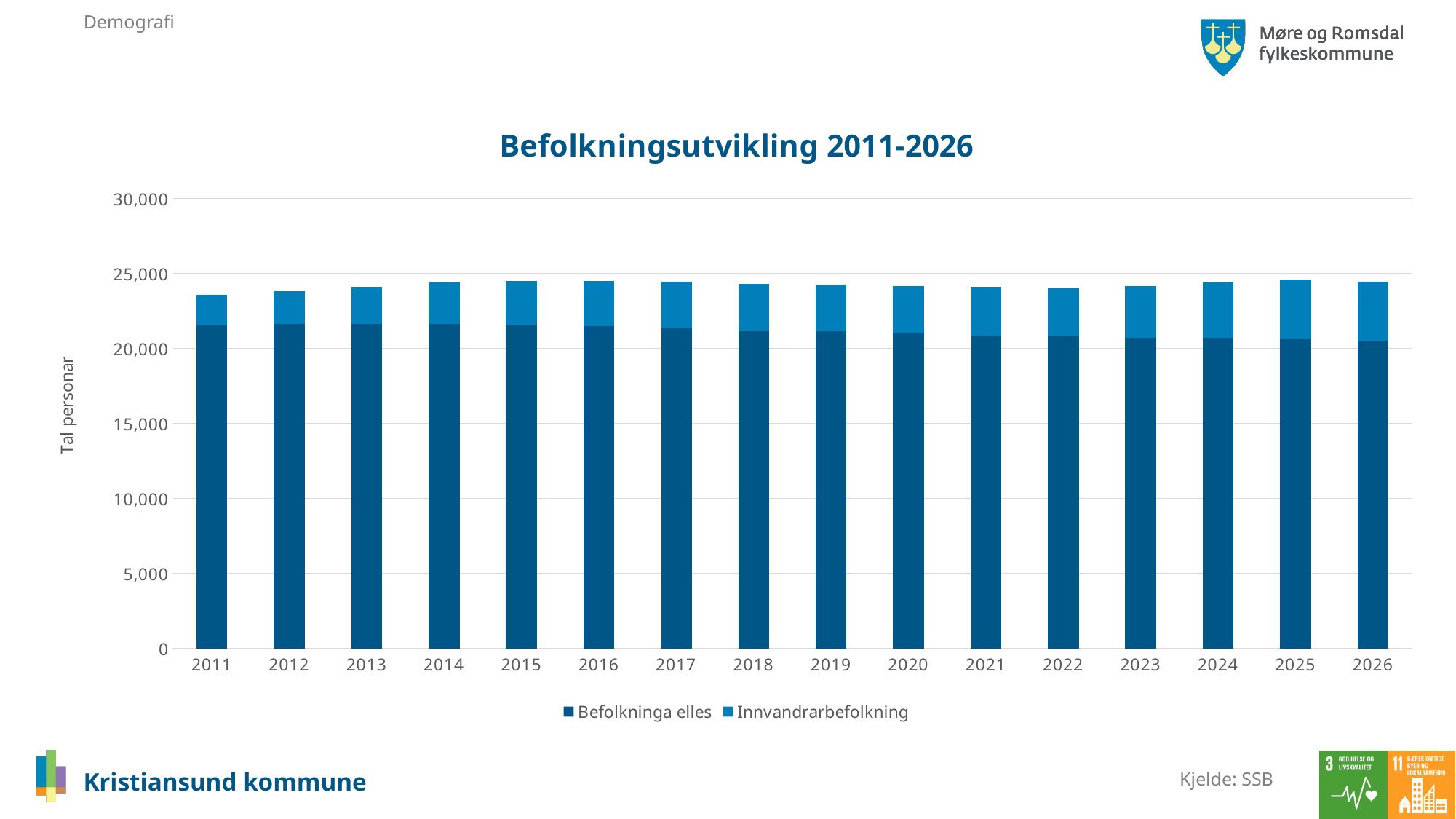
What is the title of the chart? Befolkningsutvikling 2011-2026 Which is larger, the Innvandrarbefolkning value in 2011 or in 2026? 2026 How many series does the legend list? 2 What is the label on the vertical axis? Tal personar Is the value for Befolkninga elles in 2026 greater or less than 20,000? greater Is the total bar for 2025 greater or less than 20,000? greater Is the value for Befolkninga elles in 2011 greater or less than 25,000? less What kind of chart is shown on the slide? Bar chart Does the Befolkninga elles series rise or fall from 2011 to 2026? Fall Which is larger, the Befolkninga elles value in 2011 or in 2026? 2011 How many years are shown along the x axis? 16